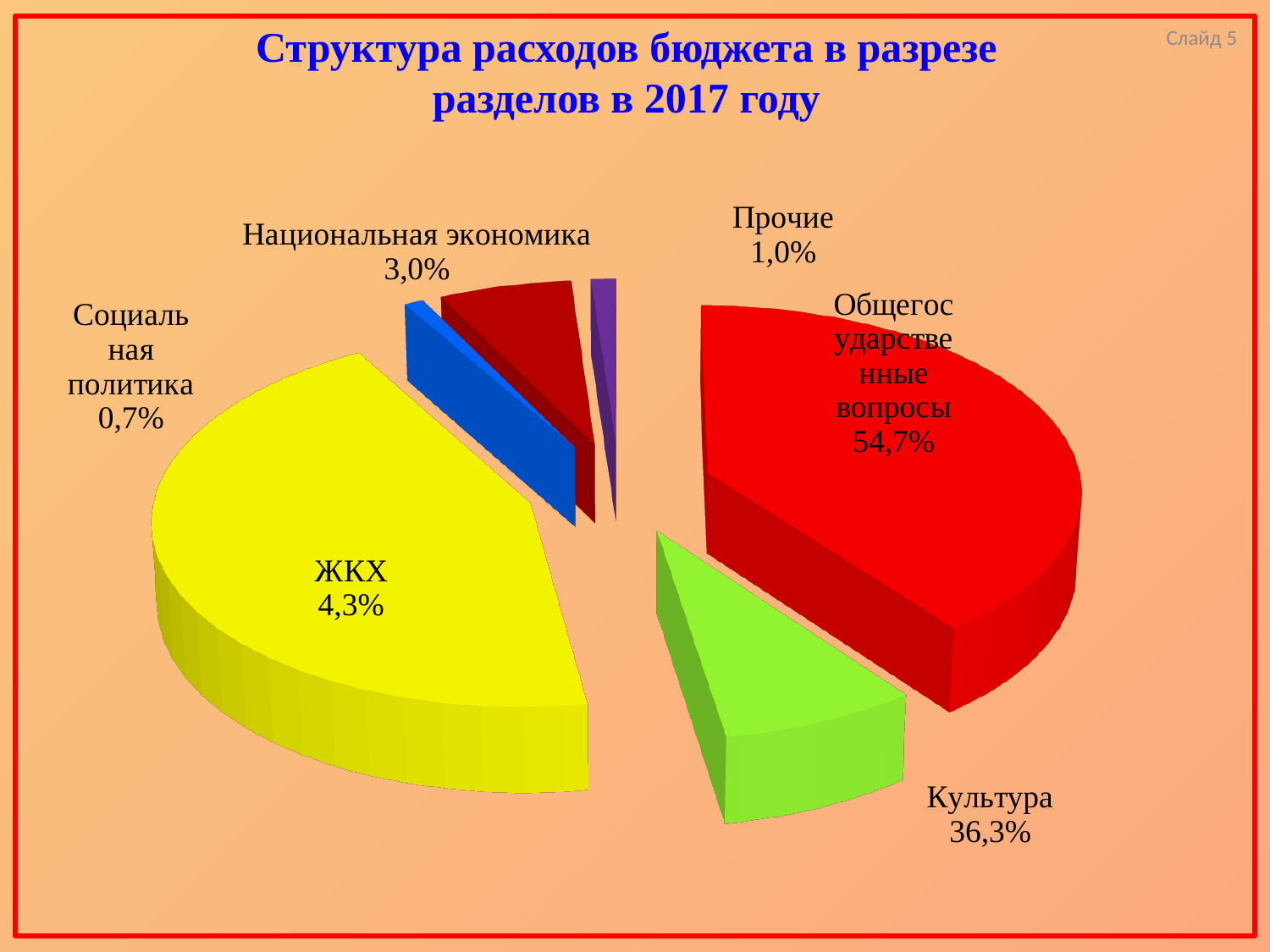
Which category has the smallest share according to the data labels? Социальная политика What type of chart is shown on the slide? Pie chart What share is shown for Социальная политика? 0,7% Which has the larger labelled share, Прочие or Социальная политика? Прочие What is the difference between the shares of Общегосударственные вопросы and Культура? 18,4% What share is shown for Национальная экономика? 3,0% What share is shown for Культура? 36,3% What is the title of the chart on the slide? Структура расходов бюджета в разрезе разделов в 2017 году How many categories are shown in the pie chart? 6 Which category has the largest share according to the data labels? Общегосударственные вопросы What share is shown for ЖКХ? 4,3% What share is shown for Общегосударственные вопросы? 54,7%